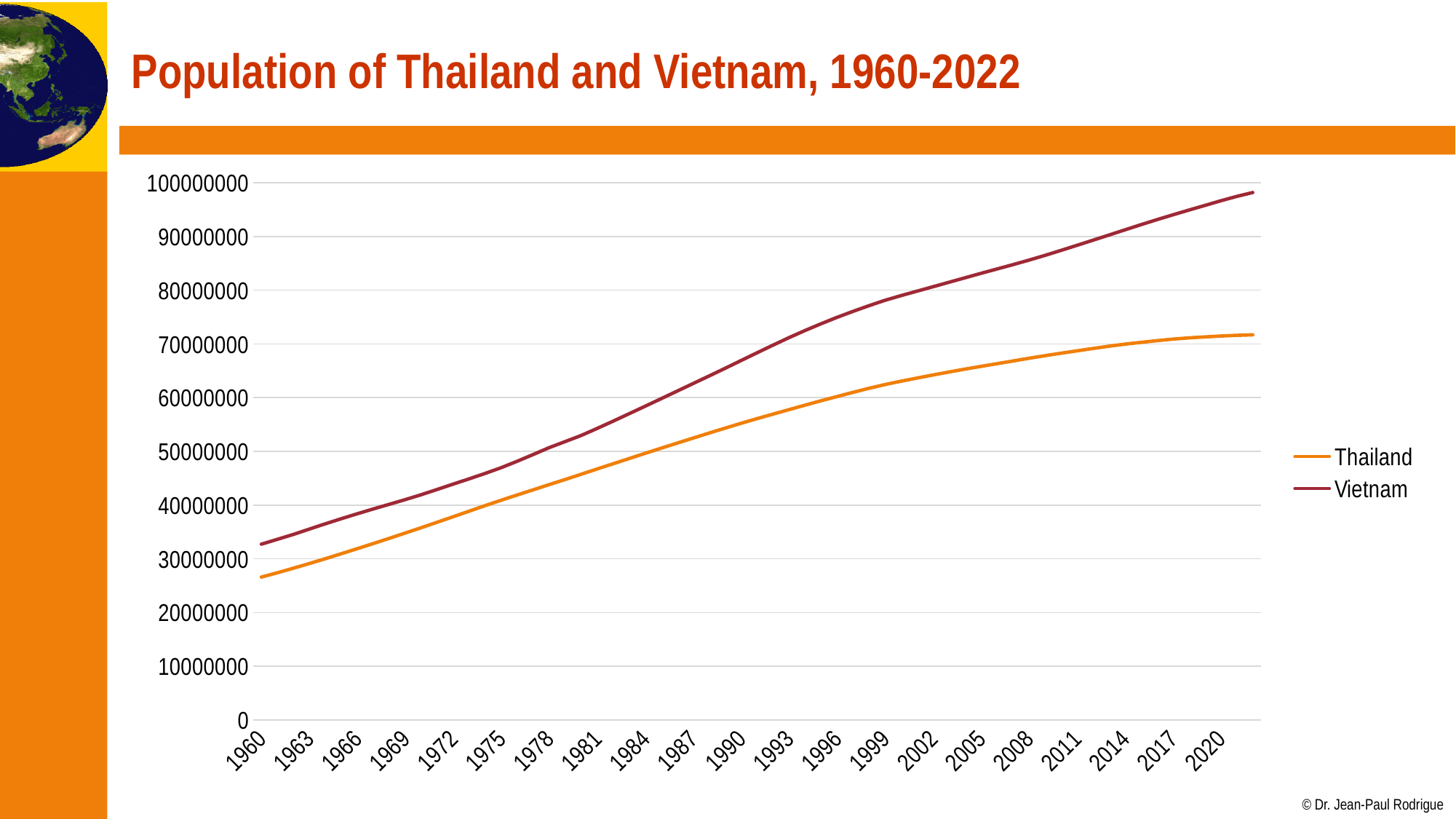
What is the title of the chart? Population of Thailand and Vietnam, 1960-2022 Is the value for Vietnam in 1960 greater or less than 30000000? greater Which series reaches the highest value on the chart? Vietnam Is the value for Thailand in 1960 greater or less than 30000000? less Does the population of Thailand rise or fall from 1960 to 2022? rise What kind of chart is shown on the slide? line chart Is the value for Vietnam in 2020 greater or less than 90000000? greater Which series has the higher value in 2020, Thailand or Vietnam? Vietnam How many series does the legend list? 2 Does the population of Vietnam rise or fall from 1960 to 2022? rise Which series is drawn in orange? Thailand